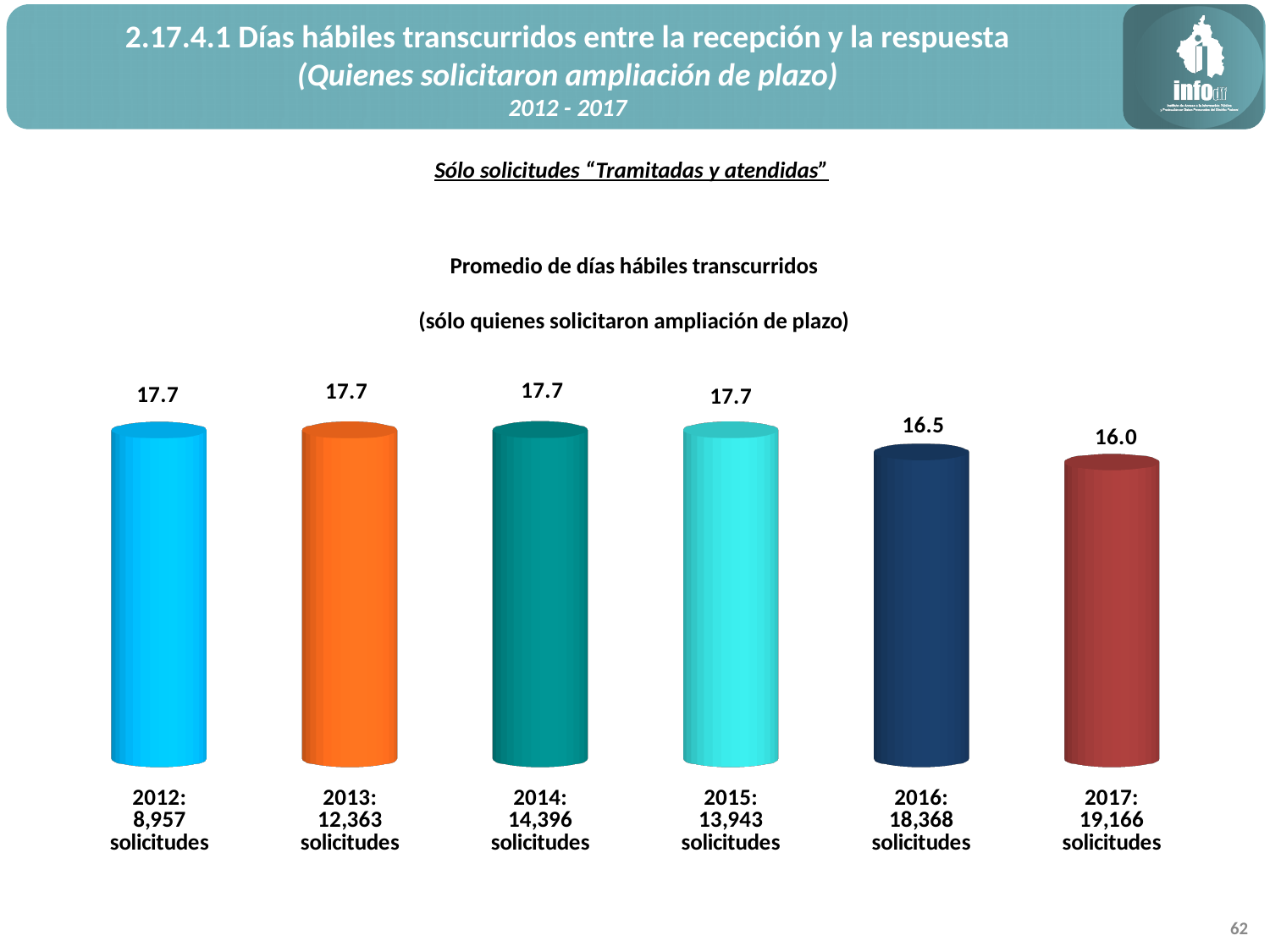
Do the average business days rise or fall from 2015 to 2017? Fall What kind of chart is shown on the slide? Bar chart Which is larger, the average business days for 2014 or for 2016? 2014 Which year has the lowest average number of business days elapsed? 2017 What is the title of the chart? Promedio de días hábiles transcurridos (sólo quienes solicitaron ampliación de plazo) What is the difference between the average business days for 2015 and 2017? 1.7 What is the difference between the average business days for 2016 and 2017? 0.5 How many years are shown in the chart? 6 What is the average number of business days elapsed for 2012? 17.7 What is the average number of business days elapsed for 2017? 16.0 How many solicitudes are listed under the 2017 bar? 19,166 solicitudes What is the average number of business days elapsed for 2016? 16.5